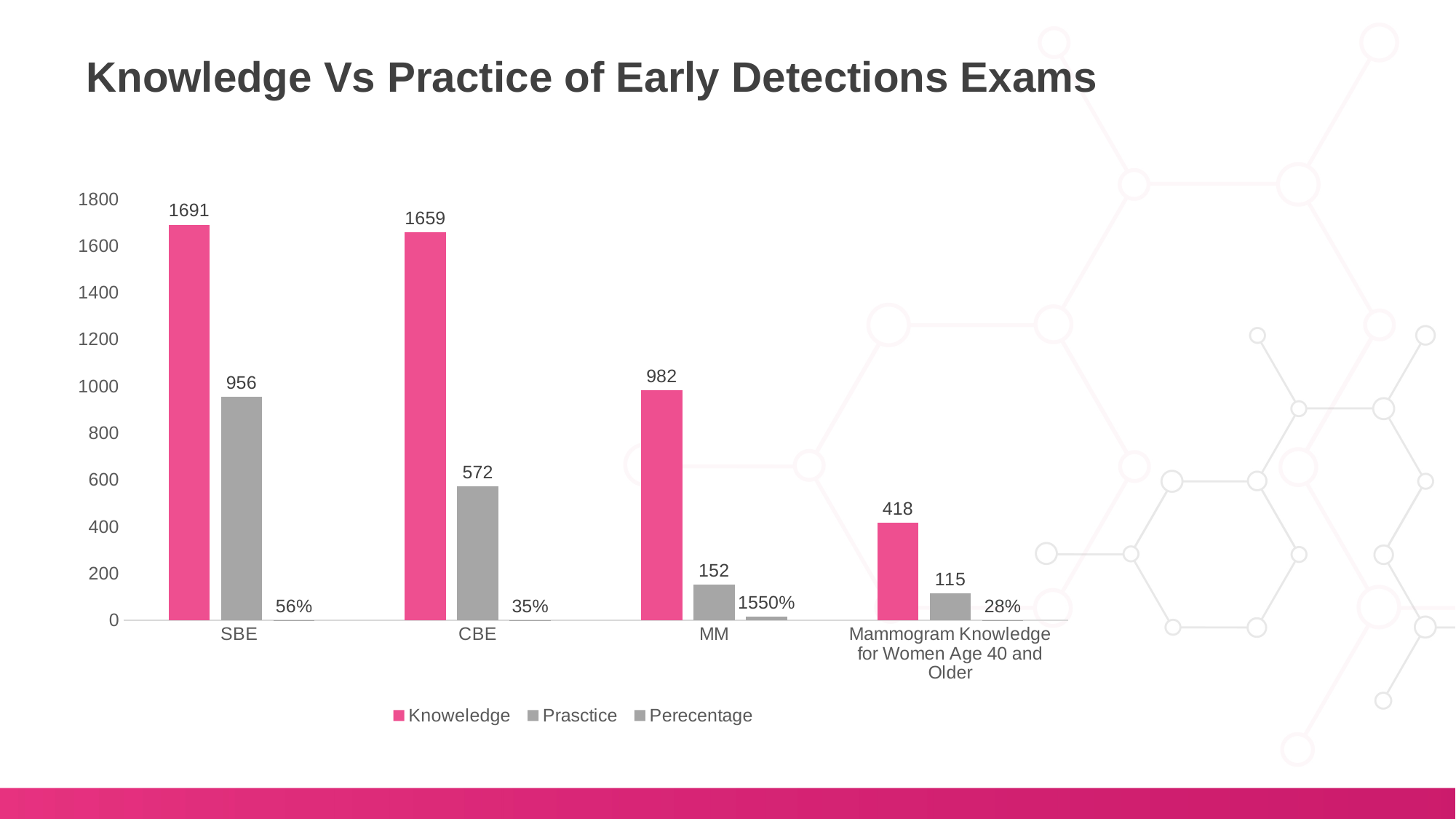
What kind of chart is shown on the slide? Bar chart What is the Knowledge value for MM? 982 What percentage is shown for SBE? 56% Which category has the lowest Practice value? Mammogram Knowledge for Women Age 40 and Older Which is larger, the Practice value for CBE or the Practice value for MM? Practice value for CBE What is the Practice value for CBE? 572 How many series does the legend list? 3 Which category has the highest Knowledge value? SBE How many categories are shown on the x axis? 4 What is the Knowledge value for SBE? 1691 What is the Practice value for Mammogram Knowledge for Women Age 40 and Older? 115 What is the difference between the Knowledge and Practice values for SBE? 735